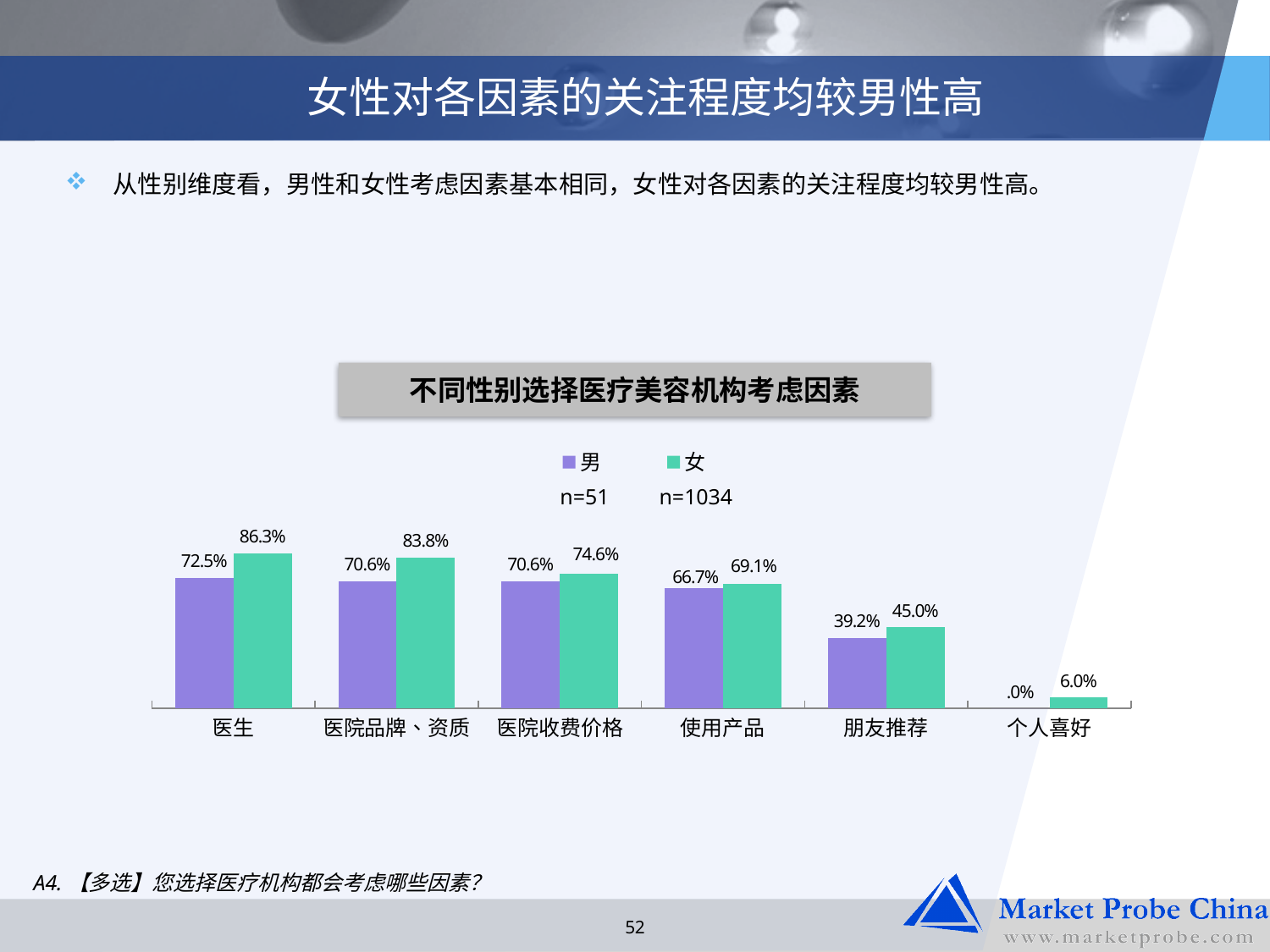
What is the value for 女 in the 个人喜好 category? 6.0% Which category has the highest value for 女? 医生 What is the difference between the 女 and 男 values for 医院品牌、资质? 13.2% Which category has the lowest value for 男? 个人喜好 What is the sample size (n) for the 女 series shown in the legend? n=1034 What is the value for 男 in the 朋友推荐 category? 39.2% What kind of chart is shown on the slide? bar chart How many categories are shown on the x axis? 6 What is the value for 女 in the 医生 category? 86.3% Which is larger for 医院收费价格: the 男 value or the 女 value? 女 What is the value for 男 in the 使用产品 category? 66.7% How many series does the legend list? 2